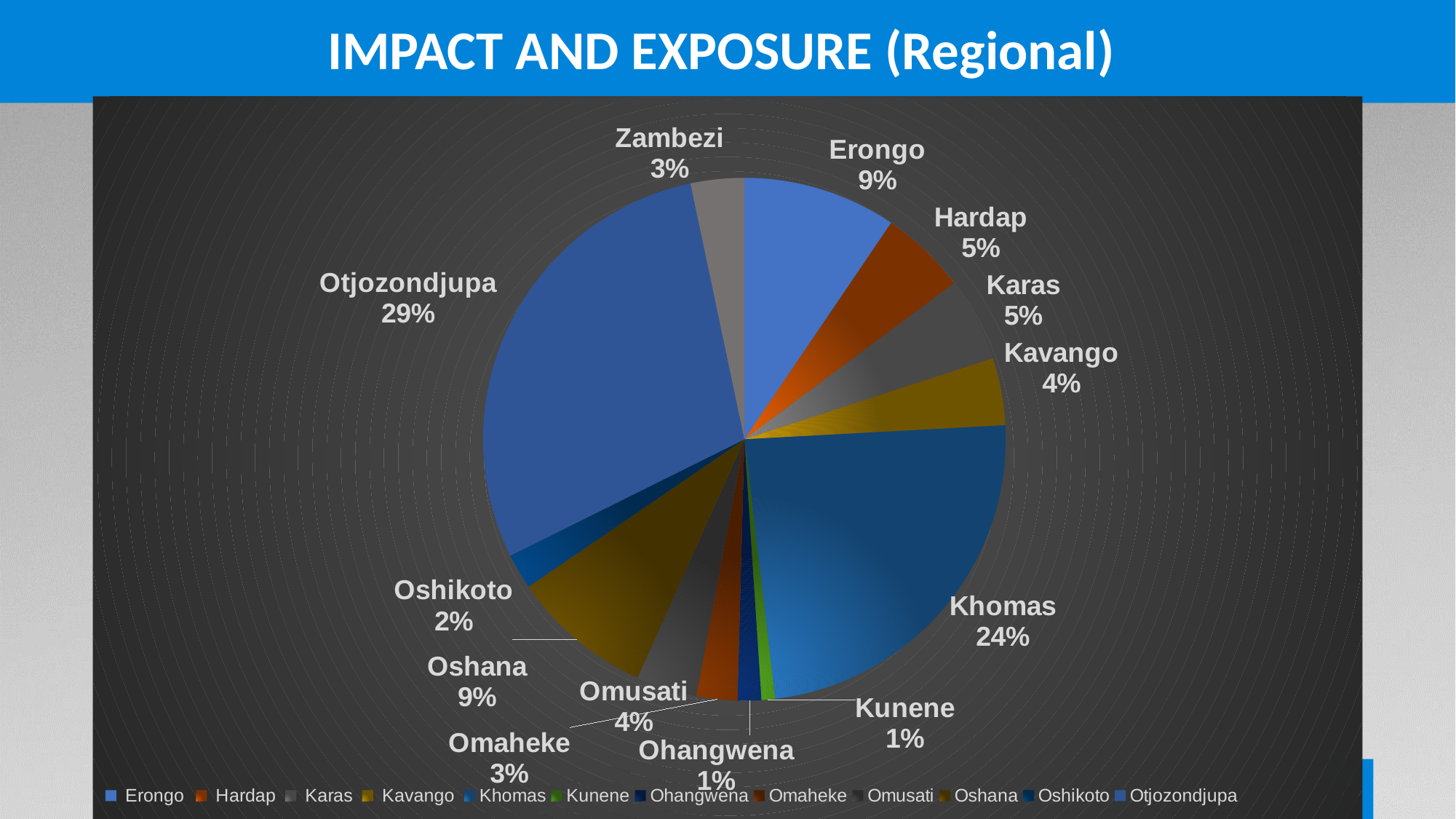
Which is larger, the share for Erongo or the share for Hardap? Erongo What share of the pie does Otjozondjupa have? 29% What is the value shown for Oshikoto? 2% What is the difference between the shares of Otjozondjupa and Khomas? 5% Which is larger, the share for Zambezi or the share for Kunene? Zambezi What is the value shown for Kavango? 4% What share of the pie does Khomas have? 24% How many regions (slices) are labelled on the pie chart? 13 What type of chart is shown on the slide? pie chart What is the difference between the shares of Oshana and Omaheke? 6% Which region has the largest slice of the pie? Otjozondjupa What is the title of the slide containing the pie chart? IMPACT AND EXPOSURE (Regional)